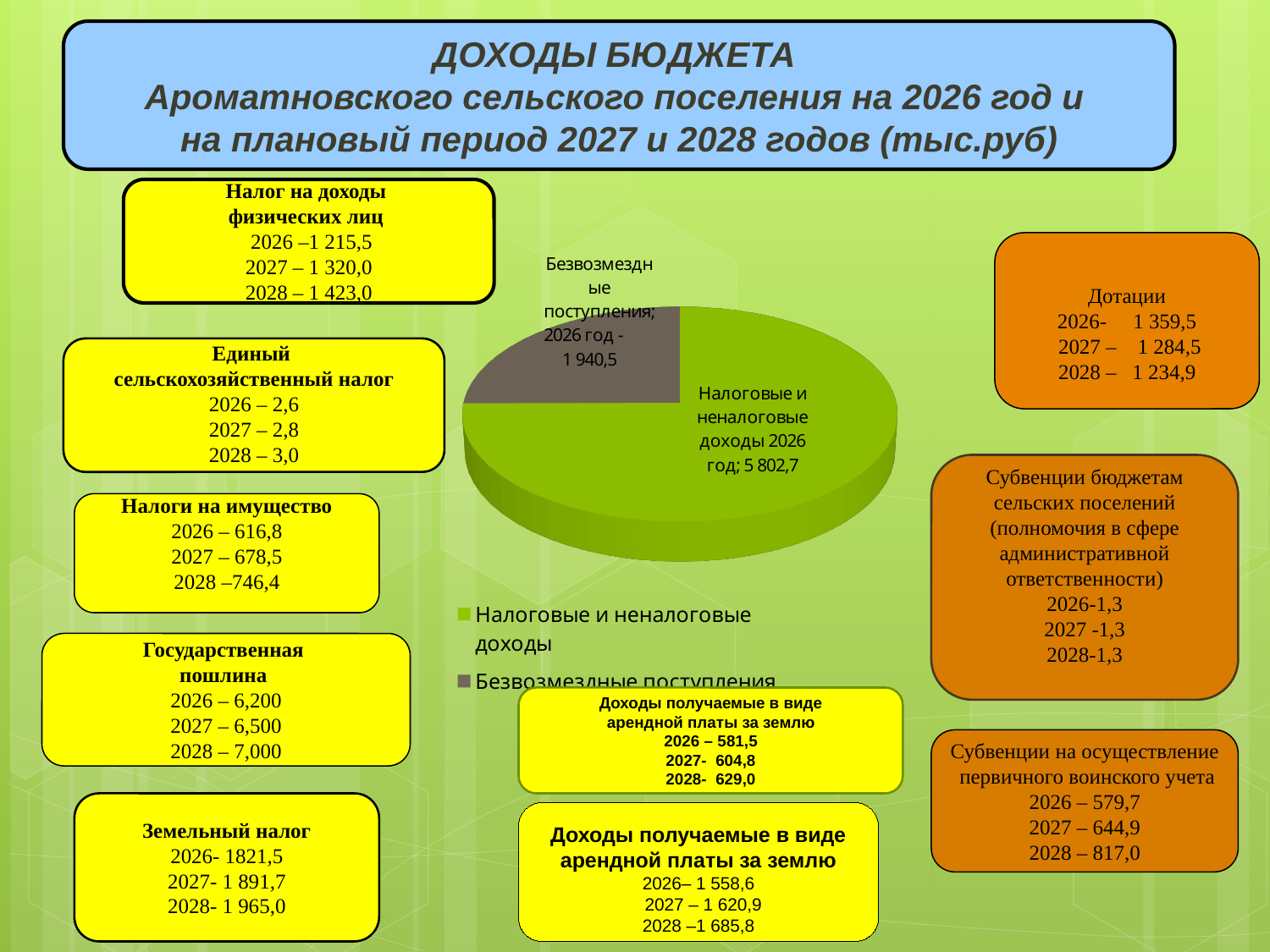
Which legend entry of the pie chart is shown in grey? Безвозмездные поступления Which is larger in the pie chart: Налоговые и неналоговые доходы or Безвозмездные поступления? Налоговые и неналоговые доходы Which slice of the pie chart is the smallest? Безвозмездные поступления How many slices does the pie chart have? 2 What value is shown for the slice "Налоговые и неналоговые доходы 2026 год" in the pie chart? 5 802,7 Which slice of the pie chart is the largest? Налоговые и неналоговые доходы What is the difference between the values of the two slices in the pie chart (5 802,7 and 1 940,5)? 3 862,2 What value is shown for the slice "Безвозмездные поступления" (2026 год) in the pie chart? 1 940,5 What colour is the slice for Налоговые и неналоговые доходы in the pie chart? Green How many entries does the legend of the pie chart list? 2 What is the total of the two slice values shown in the pie chart? 7 743,2 What kind of chart is shown in the centre of the slide? Pie chart